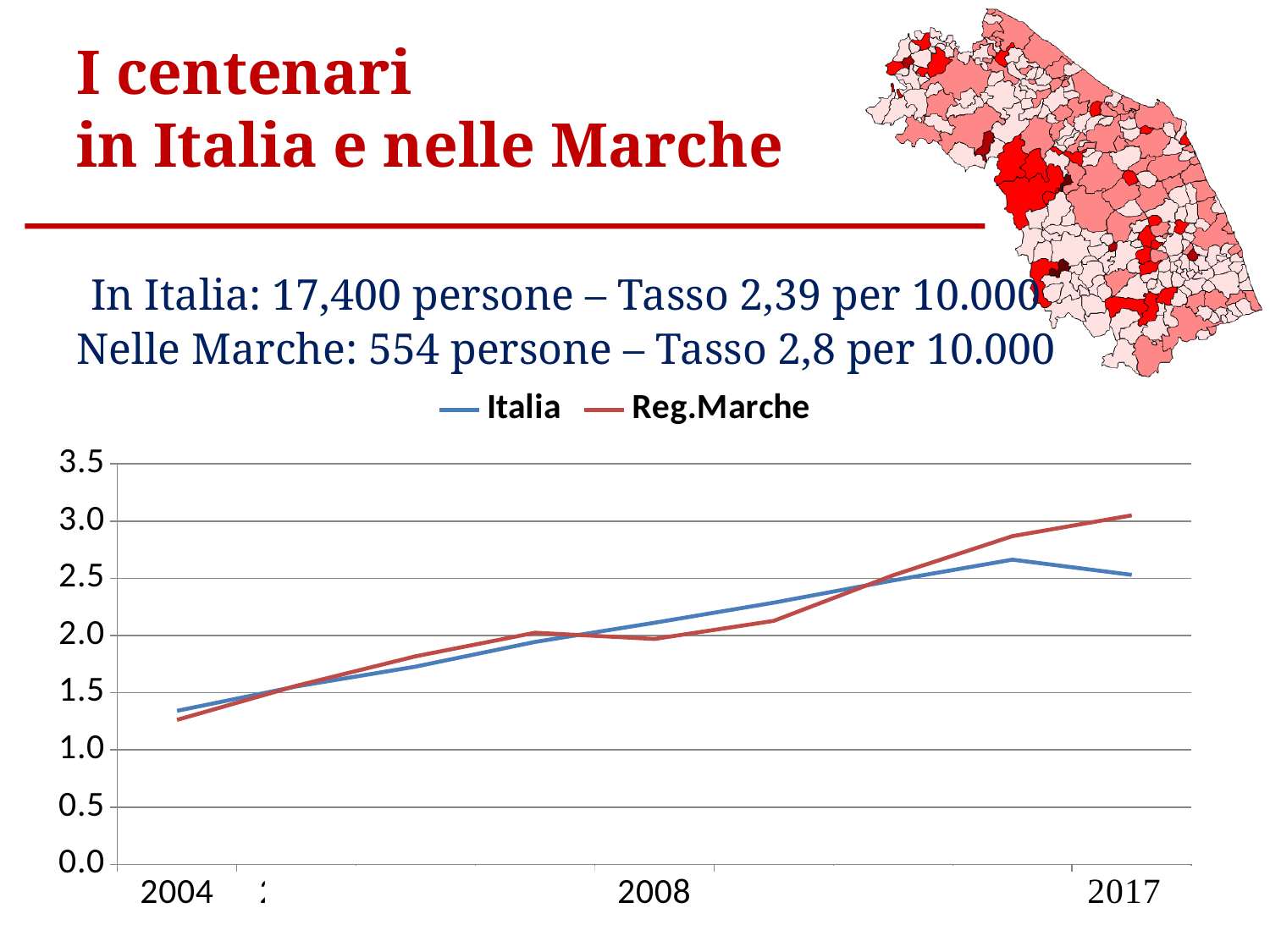
Which series has the higher value at 2017, Italia or Reg.Marche? Reg.Marche What is the highest value shown on the chart's vertical axis? 3.5 Does the Reg.Marche line generally rise or fall from 2004 to 2017? rise Which colour is used for the Italia line in the chart? blue What are the two series named in the chart legend? Italia and Reg.Marche Is the value for Reg.Marche at 2017 greater or less than 2.5? greater Which series has the higher value at 2004, Italia or Reg.Marche? Italia Is the value for Italia at 2004 greater or less than 1.5? less Is the value for Reg.Marche at 2004 greater or less than 1.5? less How many series does the chart legend list? 2 What kind of chart is shown on the slide? line chart